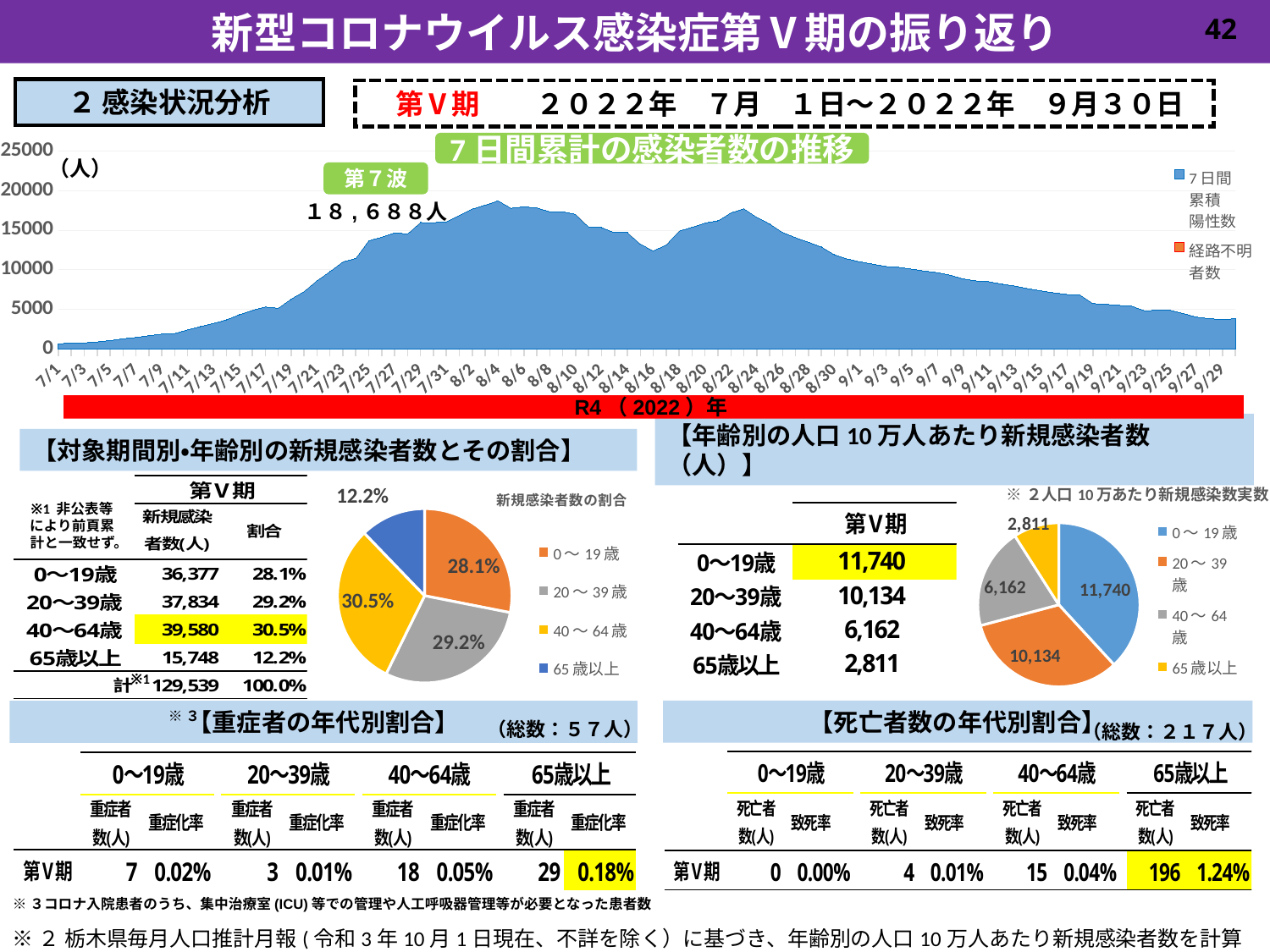
In the pie chart 新規感染者数の割合, which age group has the largest share? 40〜64歳 In the pie chart under 年齢別の人口10万人あたり新規感染者数, what is the difference between the values for 0〜19歳 and 20〜39歳? 1,606 How many series does the legend of the area chart 7日間累計の感染者数の推移 list? 2 In the area chart 7日間累計の感染者数の推移, is the value on 9/29 greater or less than 5000? less In the area chart titled 7日間累計の感染者数の推移, what peak value is labeled for 第7波? 18,688人 In the pie chart under 年齢別の人口10万人あたり新規感染者数, what is the value for 20〜39歳? 10,134 In the pie chart 新規感染者数の割合, which age group has the smallest share? 65歳以上 How many slices does the pie chart 新規感染者数の割合 have? 4 In the pie chart under 年齢別の人口10万人あたり新規感染者数, which age group has the highest value? 0〜19歳 What kind of chart is the top chart titled 7日間累計の感染者数の推移? area chart In the area chart 7日間累計の感染者数の推移, is the value on 8/24 greater or less than 15000? greater In the pie chart 新規感染者数の割合, what share does 40〜64歳 have? 30.5%